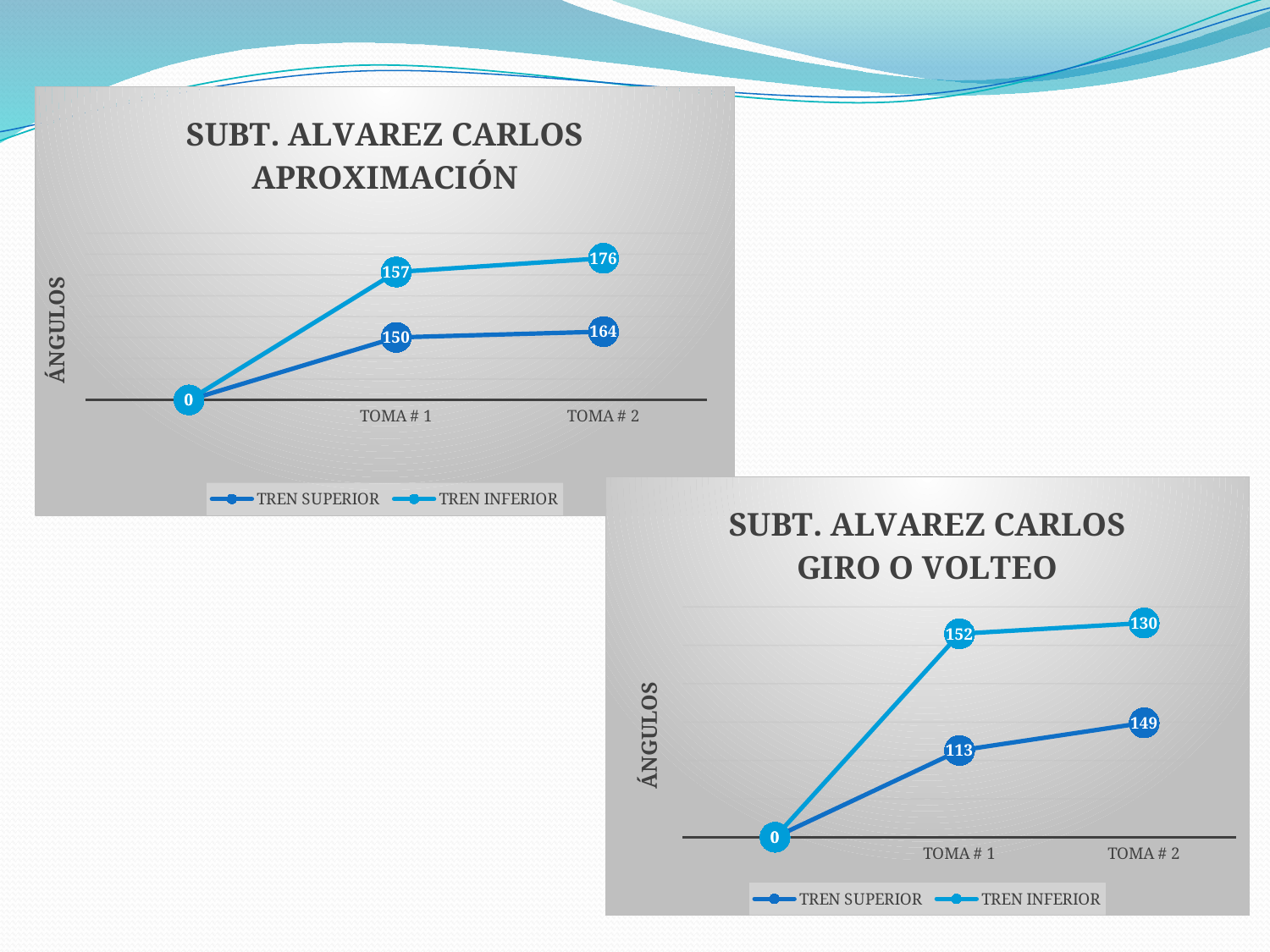
How many series does the legend of the GIRO O VOLTEO chart list? 2 In the GIRO O VOLTEO chart, what is the difference between TREN INFERIOR and TREN SUPERIOR at TOMA # 1? 39 In the GIRO O VOLTEO chart, what is the value of TREN SUPERIOR at TOMA # 1? 113 In the APROXIMACIÓN chart, does the TREN SUPERIOR series rise or fall from TOMA # 1 to TOMA # 2? rise In the APROXIMACIÓN chart, which series has the higher value at TOMA # 1, TREN SUPERIOR or TREN INFERIOR? TREN INFERIOR In the APROXIMACIÓN chart, what is the value of TREN SUPERIOR at TOMA # 1? 150 What kind of chart is the APROXIMACIÓN chart? line chart In the GIRO O VOLTEO chart, what is the value of TREN SUPERIOR at TOMA # 2? 149 In the GIRO O VOLTEO chart, what is the value of TREN INFERIOR at TOMA # 1? 152 In the APROXIMACIÓN chart, what is the value of TREN INFERIOR at TOMA # 2? 176 What is the y-axis title of the GIRO O VOLTEO chart? ÁNGULOS In the APROXIMACIÓN chart, what is the difference between TREN INFERIOR and TREN SUPERIOR at TOMA # 2? 12